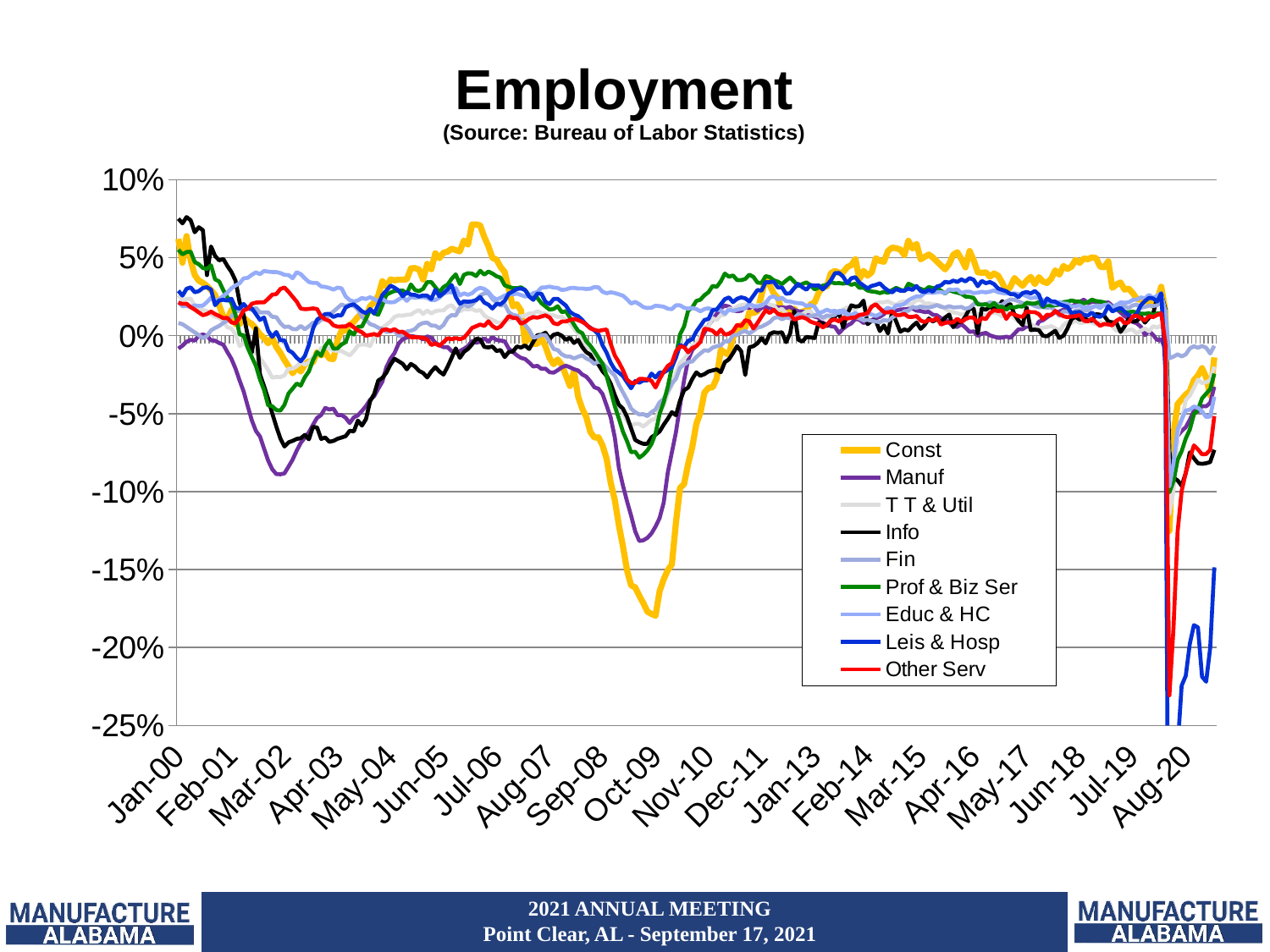
Is the peak of the Const series around Jul-06 greater or less than 5%? greater What source is cited under the chart title? Bureau of Labor Statistics Around Oct-09, which series drops lower, Const or Manuf? Const What is the title of the chart? Employment How many series does the legend list? 9 Is the lowest value of the Manuf series around Oct-09 greater or less than -10%? less What kind of chart is shown on the slide? line chart Which series reaches the lowest value anywhere on the chart? Leis & Hosp Does the Const series rise or fall between Sep-08 and Oct-09? fall Is the lowest value of the Const series (around Oct-09) greater or less than -15%? less How many date labels are shown on the x axis? 20